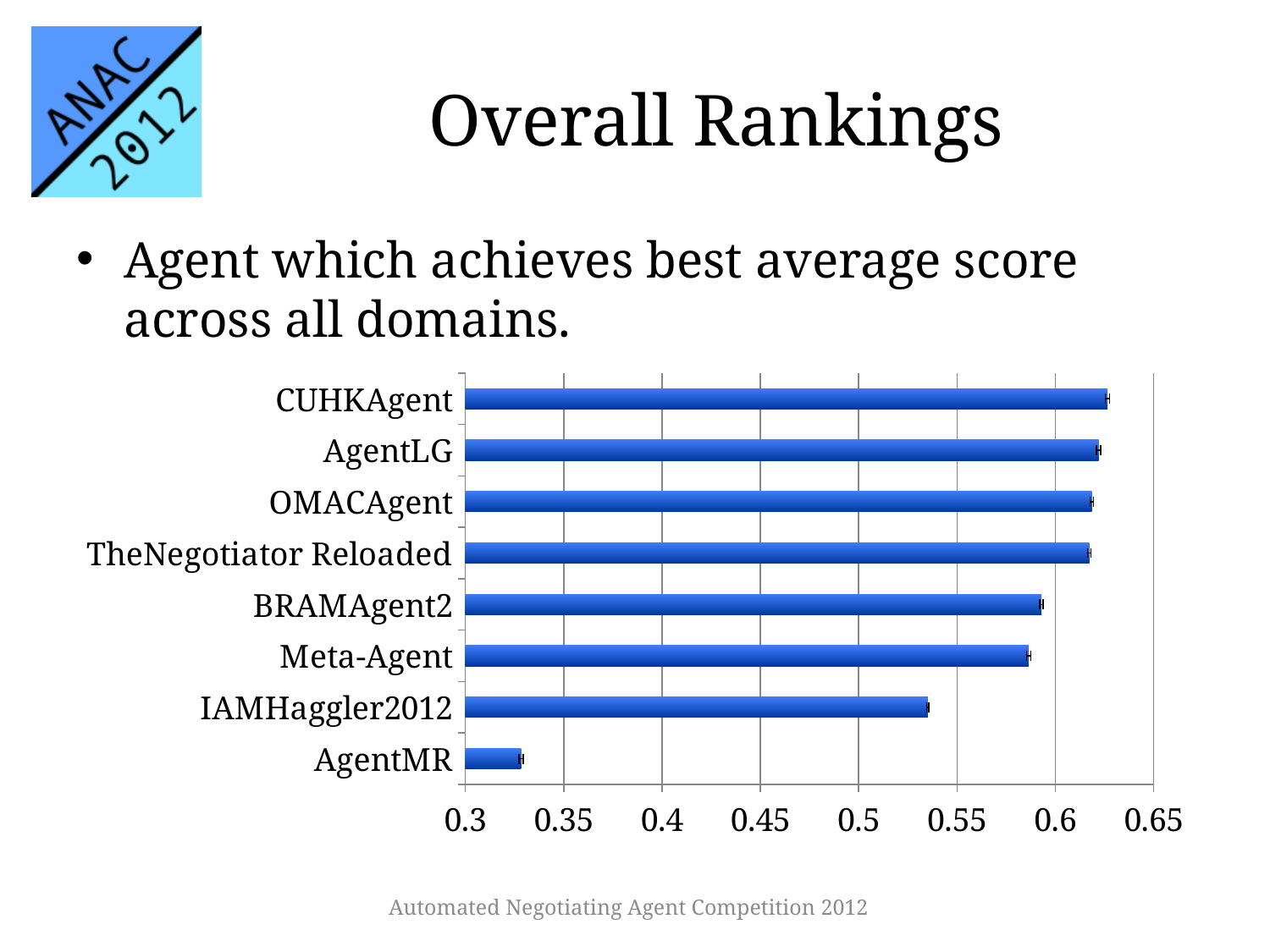
Is the value for AgentMR greater or less than 0.35? less Is the value for IAMHaggler2012 greater or less than 0.55? less Which has the larger value, Meta-Agent or IAMHaggler2012? Meta-Agent Which has the larger value, AgentMR or BRAMAgent2? BRAMAgent2 Is the value for Meta-Agent greater or less than 0.55? greater How many agents are listed in the chart? 8 What is the title of the slide containing the chart? Overall Rankings What kind of chart is shown on the slide? Bar chart Which agent has the lowest average score in the chart? AgentMR